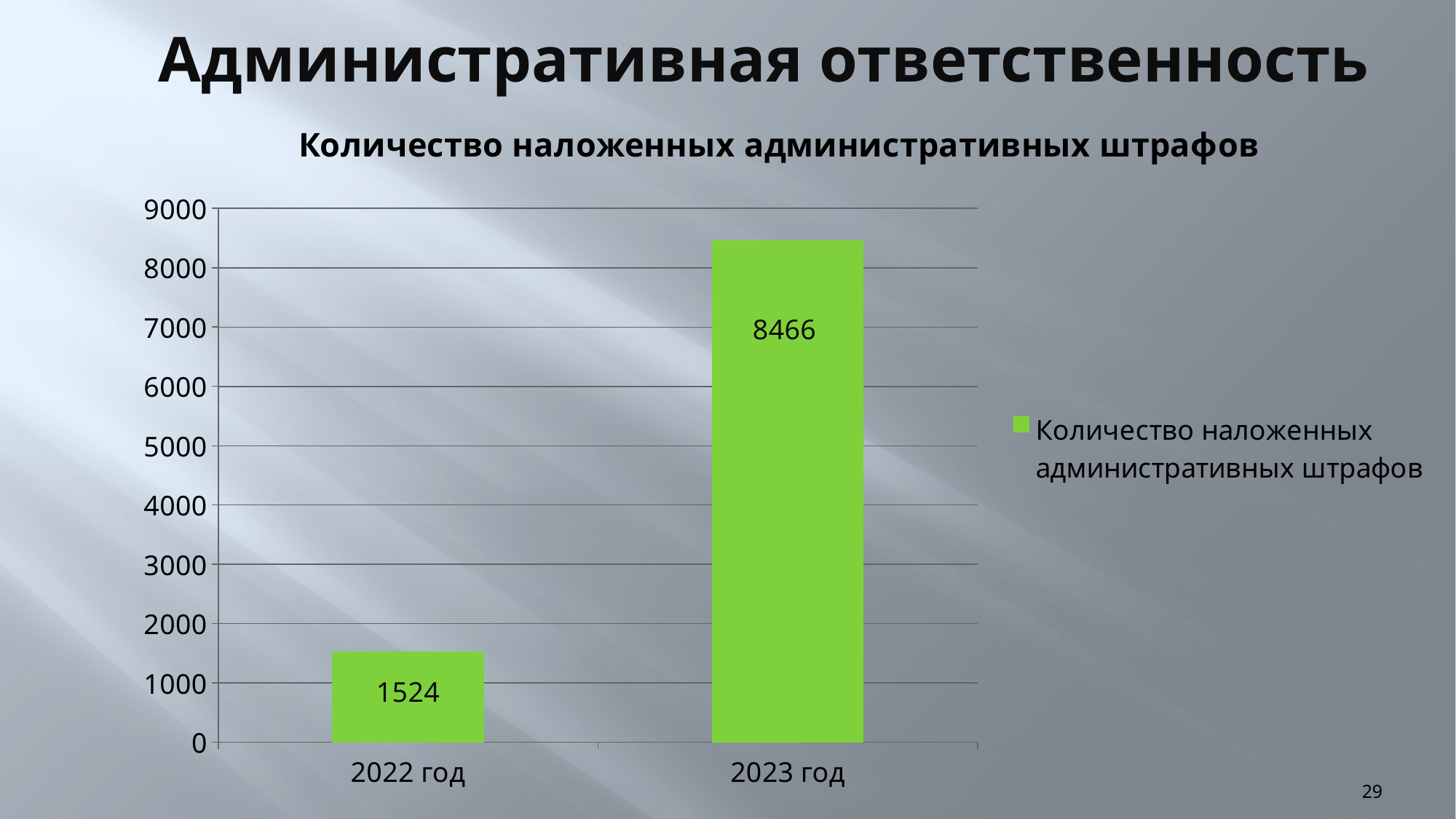
Is the value for 2023 год greater or less than 8000? greater Which is larger, the value for 2022 год or the value for 2023 год? 2023 год What is the difference between the values for 2023 год and 2022 год? 6942 How many categories are shown on the x axis? 2 What is the value for 2022 год? 1524 What is the value for 2023 год? 8466 Is the value for 2022 год greater or less than 2000? less What kind of chart is shown on the slide? bar chart What is the title of the chart? Количество наложенных административных штрафов How many series does the legend list? 1 Which year has the lowest number of imposed administrative fines? 2022 год Which year has the highest number of imposed administrative fines? 2023 год